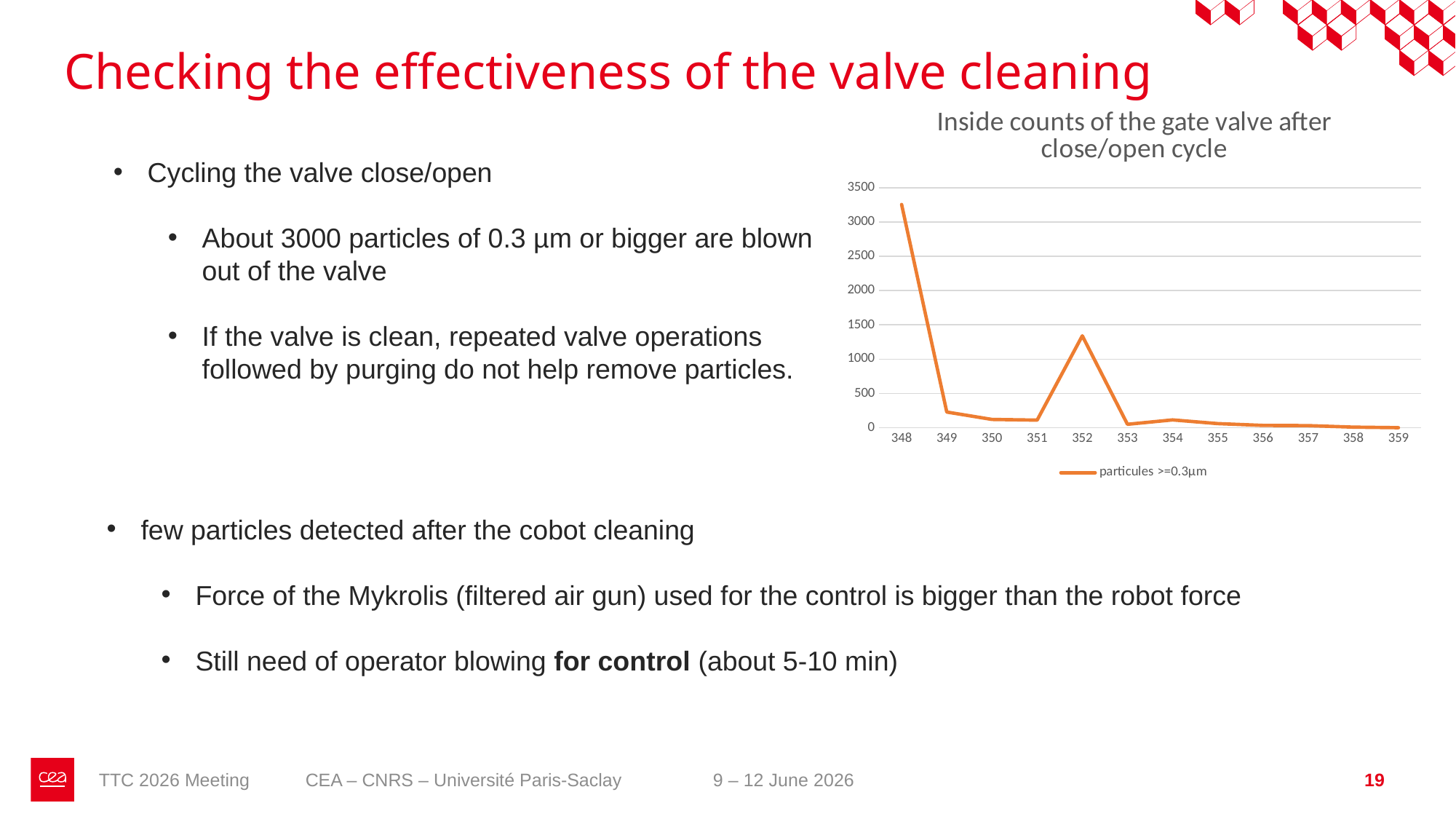
How many points are plotted along the x axis? 12 Is the value at 348 greater or less than 3000? greater What is the name of the series shown in the legend? particules >=0.3µm Which has the larger value, 348 or 352? 348 How many series does the chart legend list? 1 At which x-axis value is the particle count highest? 348 Is the value at 353 greater or less than 500? less Is the value at 349 greater or less than 500? less Which has the larger value, 351 or 352? 352 What kind of chart is shown on the slide? line chart What is the title of the chart? Inside counts of the gate valve after close/open cycle